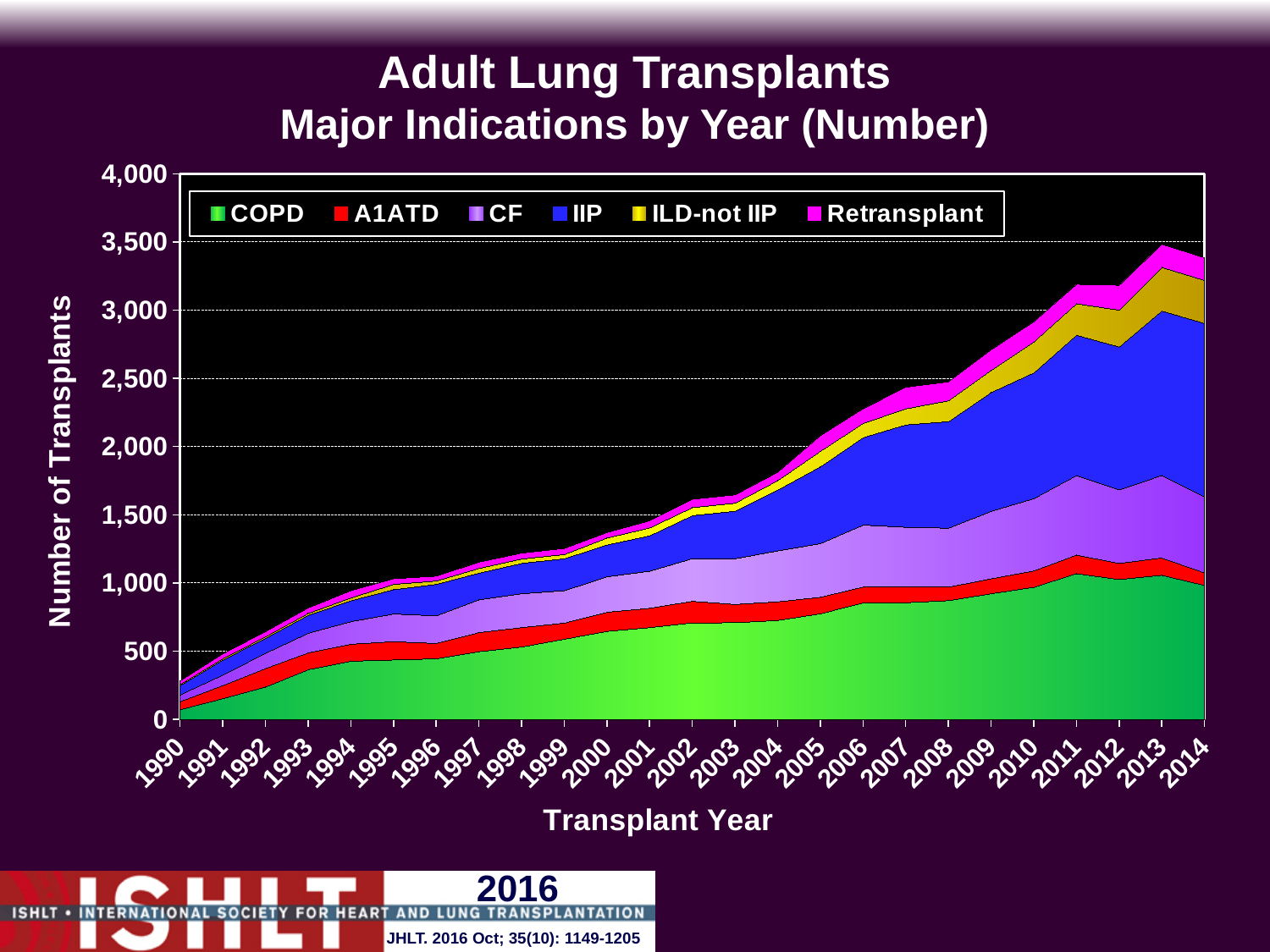
How many series does the legend list? 6 How many transplant years are plotted along the x axis? 25 Is the total number of transplants in 2000 greater or less than 1,000? greater Does the total number of adult lung transplants rise or fall from 1990 to 2014? Rise Which indication is shown in green in the legend? COPD What is the label of the y axis? Number of Transplants Is the total number of transplants in 2014 greater or less than 3,000? greater In 2014, which indication accounts for more transplants, COPD or IIP? IIP Which transplant year has the lowest total number of transplants? 1990 What kind of chart is shown on the slide? Stacked area chart Is the total number of transplants in 1990 greater or less than 500? less